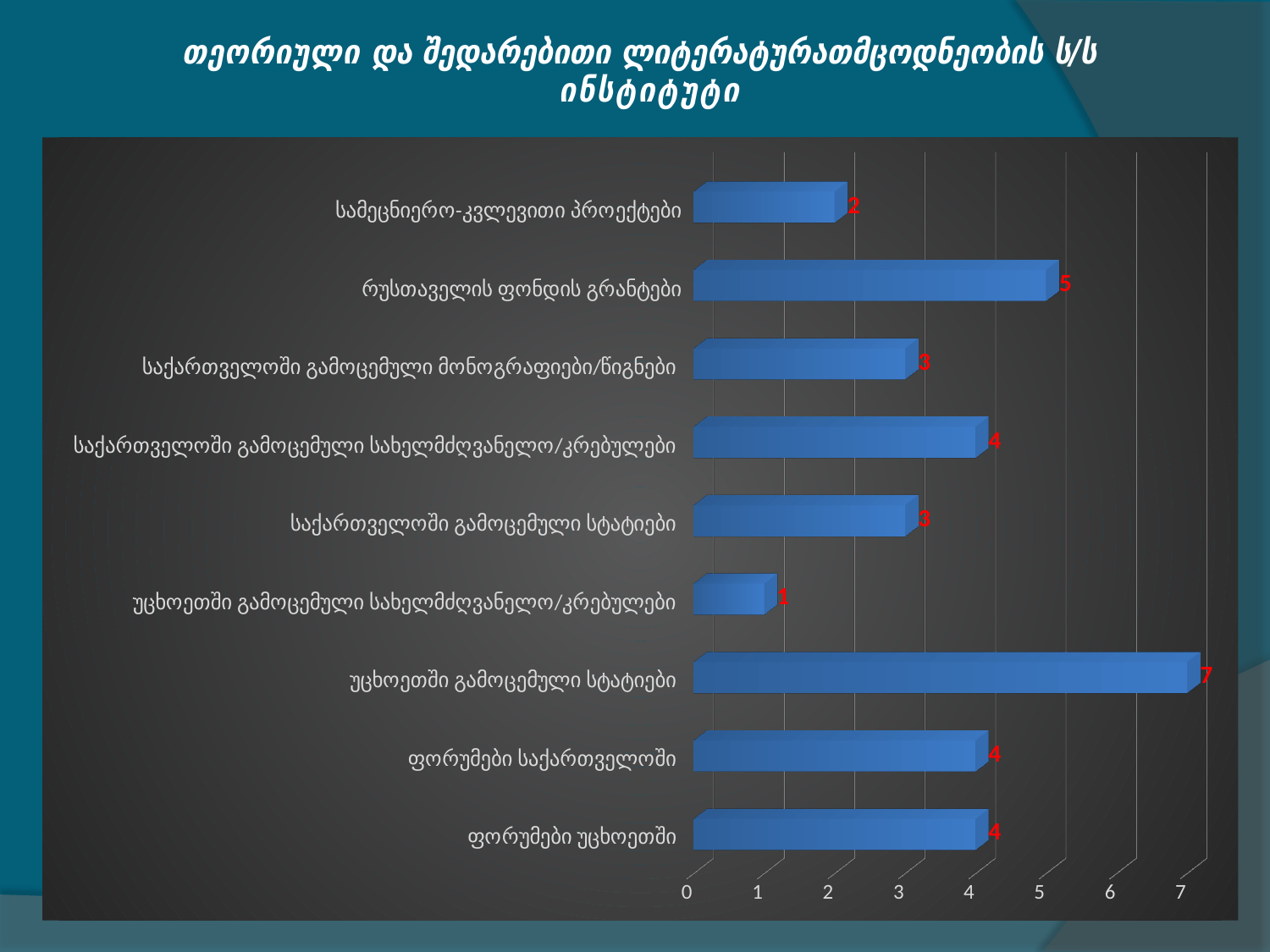
What is the value for უცხოეთში გამოცემული სახელმძღვანელო/კრებულები? 1 Which is larger: the value for რუსთაველის ფონდის გრანტები or the value for ფორუმები უცხოეთში? რუსთაველის ფონდის გრანტები Which category has the highest value? უცხოეთში გამოცემული სტატიები What is the value for სამეცნიერო-კვლევითი პროექტები? 2 What is the title of the slide? თეორიული და შედარებითი ლიტერატურათმცოდნეობის ს/ს ინსტიტუტი What is the value for რუსთაველის ფონდის გრანტები? 5 What is the value for ფორუმები საქართველოში? 4 How many categories are shown in the chart? 9 What is the difference between the values for უცხოეთში გამოცემული სტატიები and საქართველოში გამოცემული სტატიები? 4 What is the value for უცხოეთში გამოცემული სტატიები? 7 What kind of chart is shown on the slide? Bar chart Which category has the lowest value? უცხოეთში გამოცემული სახელმძღვანელო/კრებულები